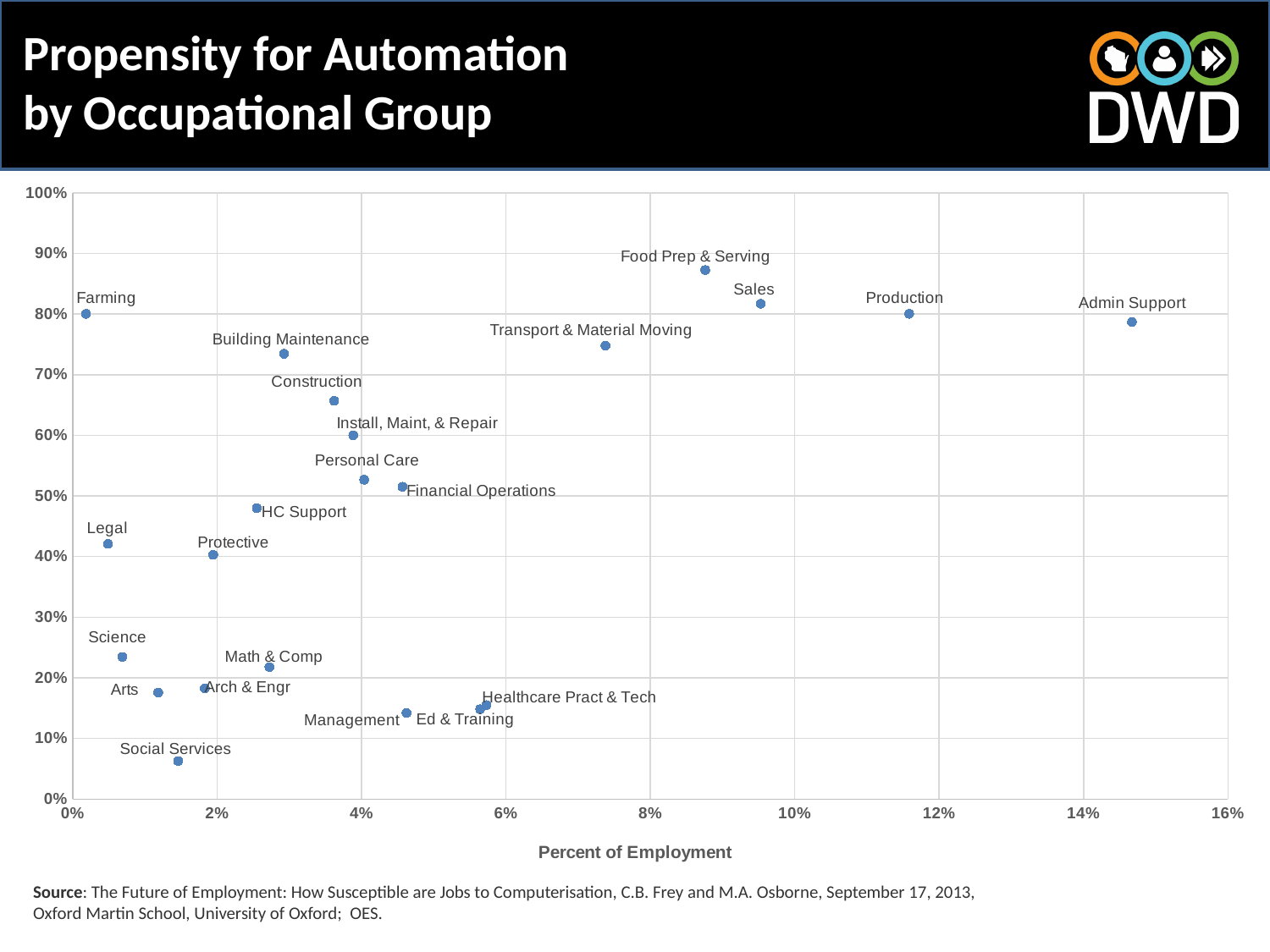
Is the propensity for automation for Food Prep & Serving greater or less than 80%? greater What is the title of the chart on the slide? Propensity for Automation by Occupational Group Is the propensity for automation for Social Services greater or less than 10%? less Which occupational group has the highest propensity for automation? Food Prep & Serving Which has a higher propensity for automation, Building Maintenance or Construction? Building Maintenance Is the percent of employment for Admin Support greater or less than 14%? greater What is the label of the horizontal axis? Percent of Employment Which has a higher propensity for automation, Sales or Transport & Material Moving? Sales How many occupational groups are plotted on the chart? 22 What kind of chart is shown on the slide? Scatter chart Which occupational group has the highest percent of employment? Admin Support Which occupational group has the lowest propensity for automation? Social Services